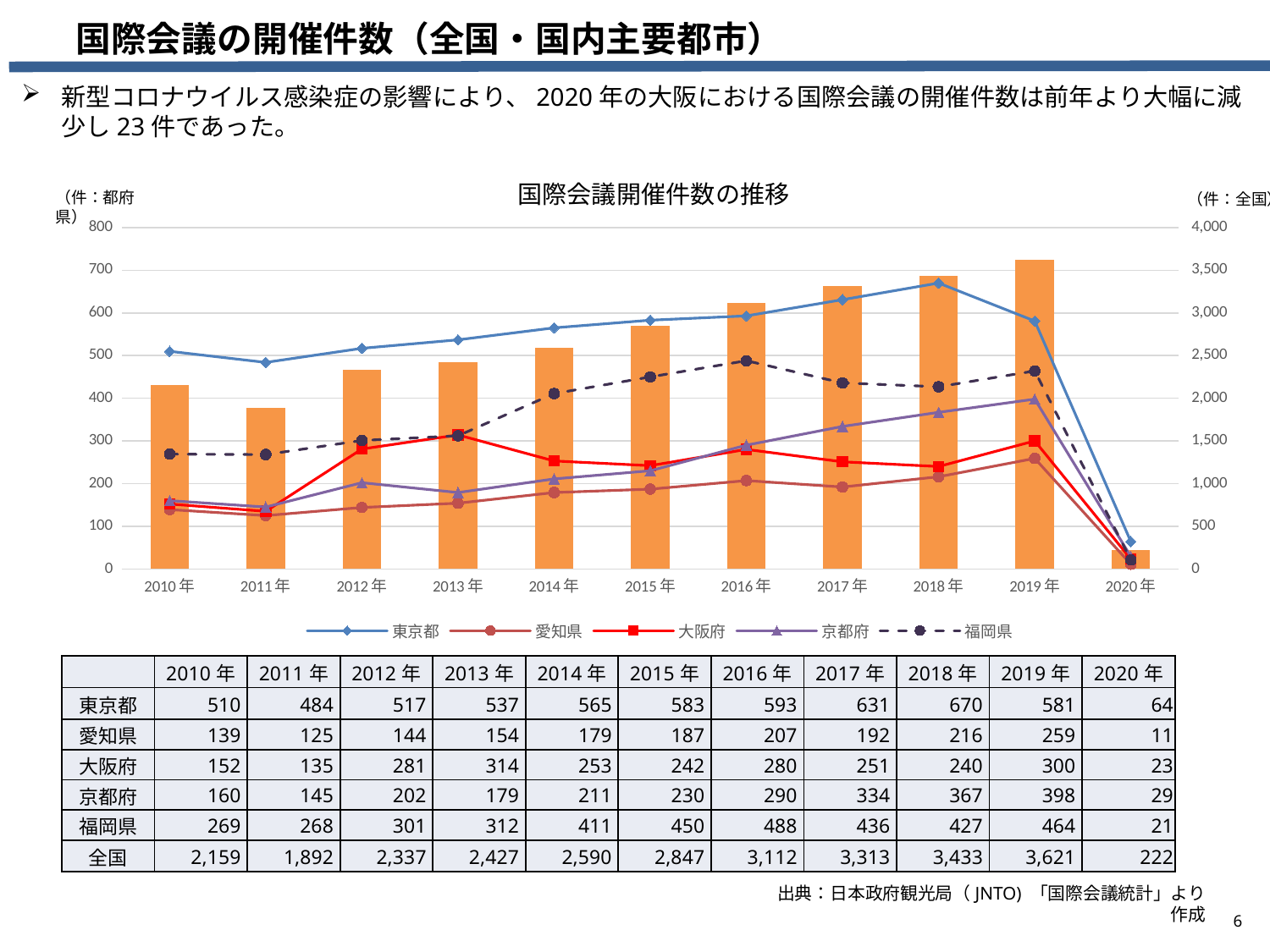
In which year is the value for 全国 lowest? 2020年 What is the value for 大阪府 in 2020年? 23 Do the 全国 bars rise or fall from 2011年 to 2019年? Rise In 2019年, which is larger, the value for 京都府 or the value for 大阪府? 京都府 What is the value for 全国 in 2019年? 3,621 What is the title of the chart? 国際会議開催件数の推移 How many years are shown along the x axis of the chart? 11 What is the difference between the 東京都 values for 2019年 and 2020年? 517 What kind of chart is this? A combined bar and line chart What is the value for 東京都 in 2018年? 670 How many series does the chart legend list? 5 In which year is the value for 東京都 highest? 2018年